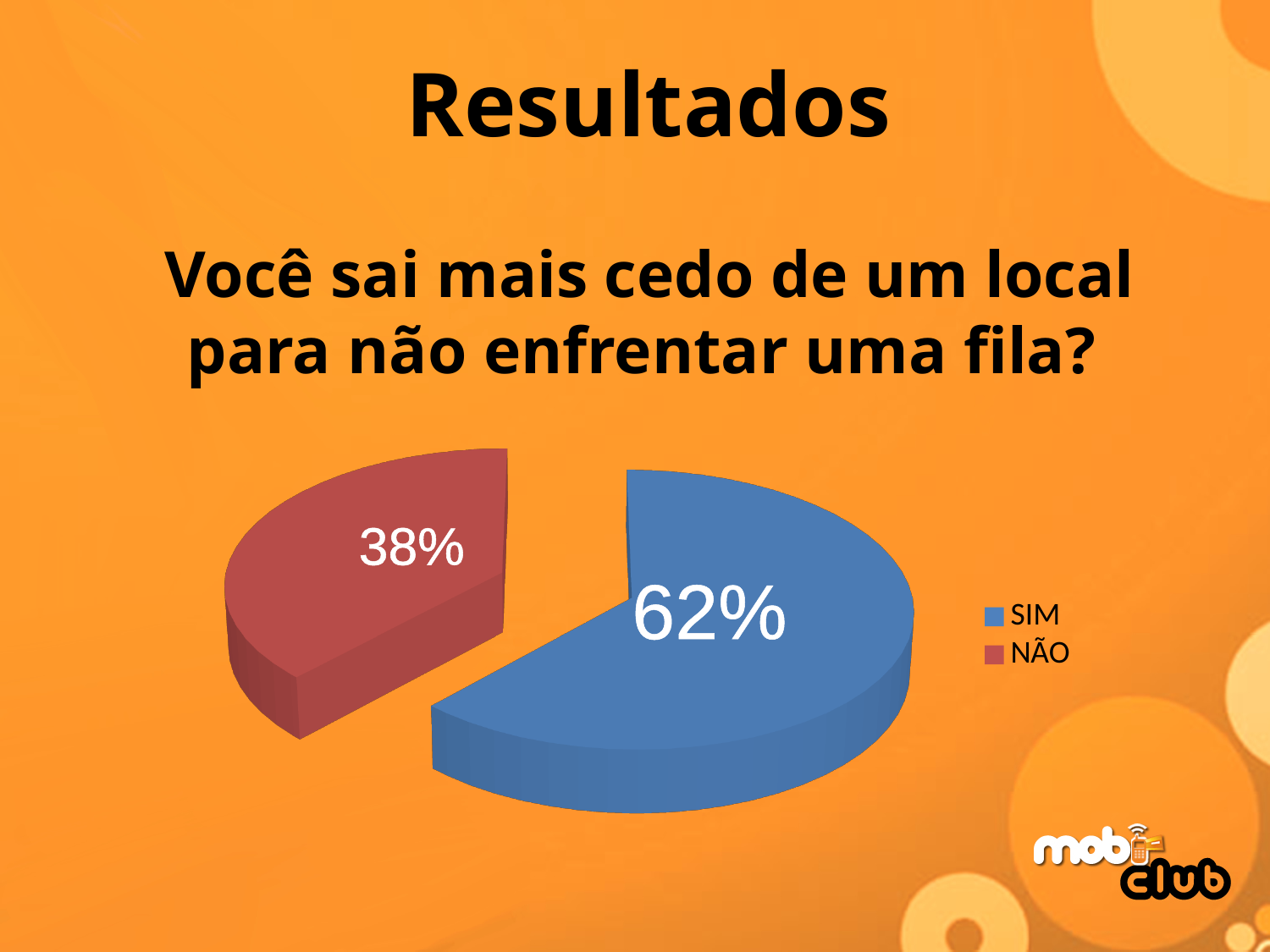
Which response has the smallest share of the pie? NÃO What question is the chart answering? Você sai mais cedo de um local para não enfrentar uma fila? Which response has the largest share of the pie? SIM What percentage of respondents answered NÃO? 38% What is the difference in percentage points between SIM and NÃO? 24 What share of the pie does the SIM slice represent? 62% What kind of chart is shown on the slide? Pie chart How many slices does the pie chart have? 2 How many entries does the legend list? 2 Which is larger, the share for SIM or the share for NÃO? SIM What colour is the slice for NÃO? Red What percentage of respondents answered SIM? 62%